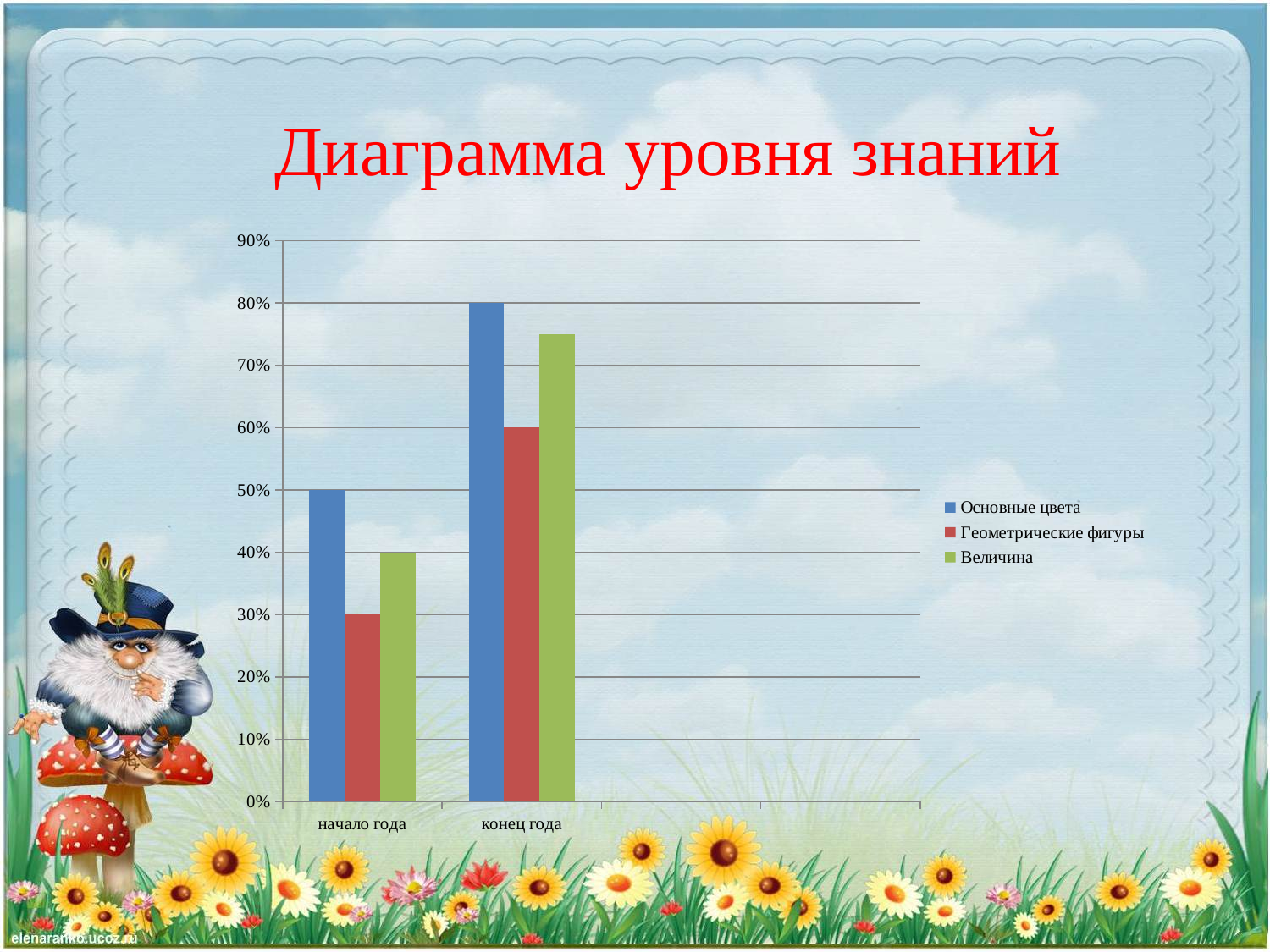
How many series does the legend list? 3 What is the value for Геометрические фигуры at начало года? 30% What is the value for Основные цвета at конец года? 80% Is the value for Величина at конец года greater or less than 70%? greater What is the difference between the Основные цвета values at конец года and начало года? 30% What is the title of the chart? Диаграмма уровня знаний Which series has the lowest value at начало года? Геометрические фигуры What is the value for Основные цвета at начало года? 50% How many categories are shown on the x axis? 2 What is the value for Геометрические фигуры at конец года? 60% Does the value for Величина rise or fall from начало года to конец года? rise What kind of chart is shown on the slide? bar chart